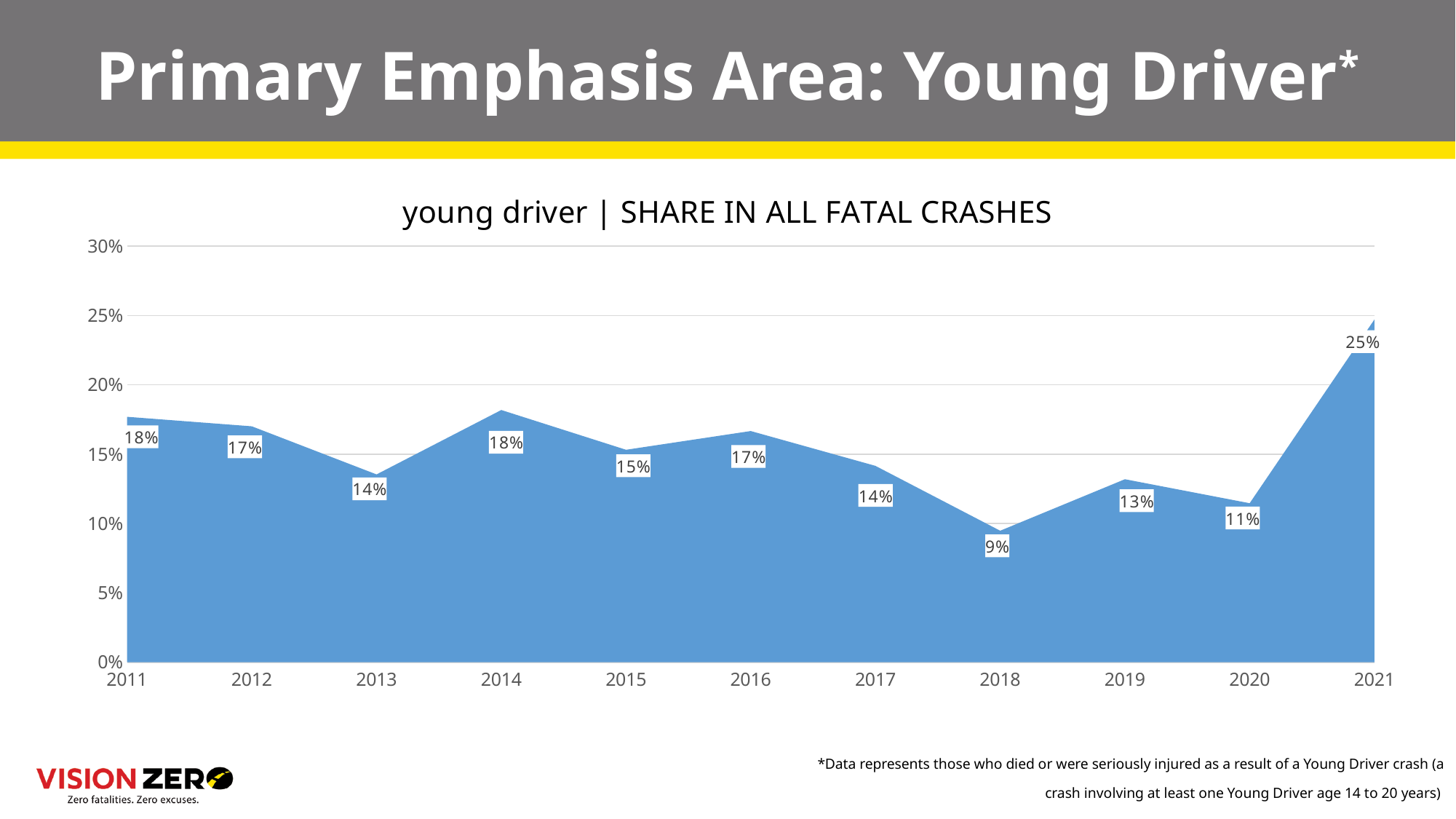
What is the young driver share in all fatal crashes for 2021? 25% What is the title of the chart? young driver | SHARE IN ALL FATAL CRASHES Which year has the lowest young driver share in all fatal crashes? 2018 What is the young driver share in all fatal crashes for 2018? 9% What is the difference between the young driver share in 2011 and in 2018? 9% What is the young driver share in all fatal crashes for 2013? 14% Which year has a larger young driver share in all fatal crashes, 2016 or 2017? 2016 Which year has the highest young driver share in all fatal crashes? 2021 What is the young driver share in all fatal crashes for 2020? 11% What kind of chart is shown on the slide? Area chart How many years are plotted on the chart? 11 What is the difference between the young driver share in 2021 and in 2020? 14%